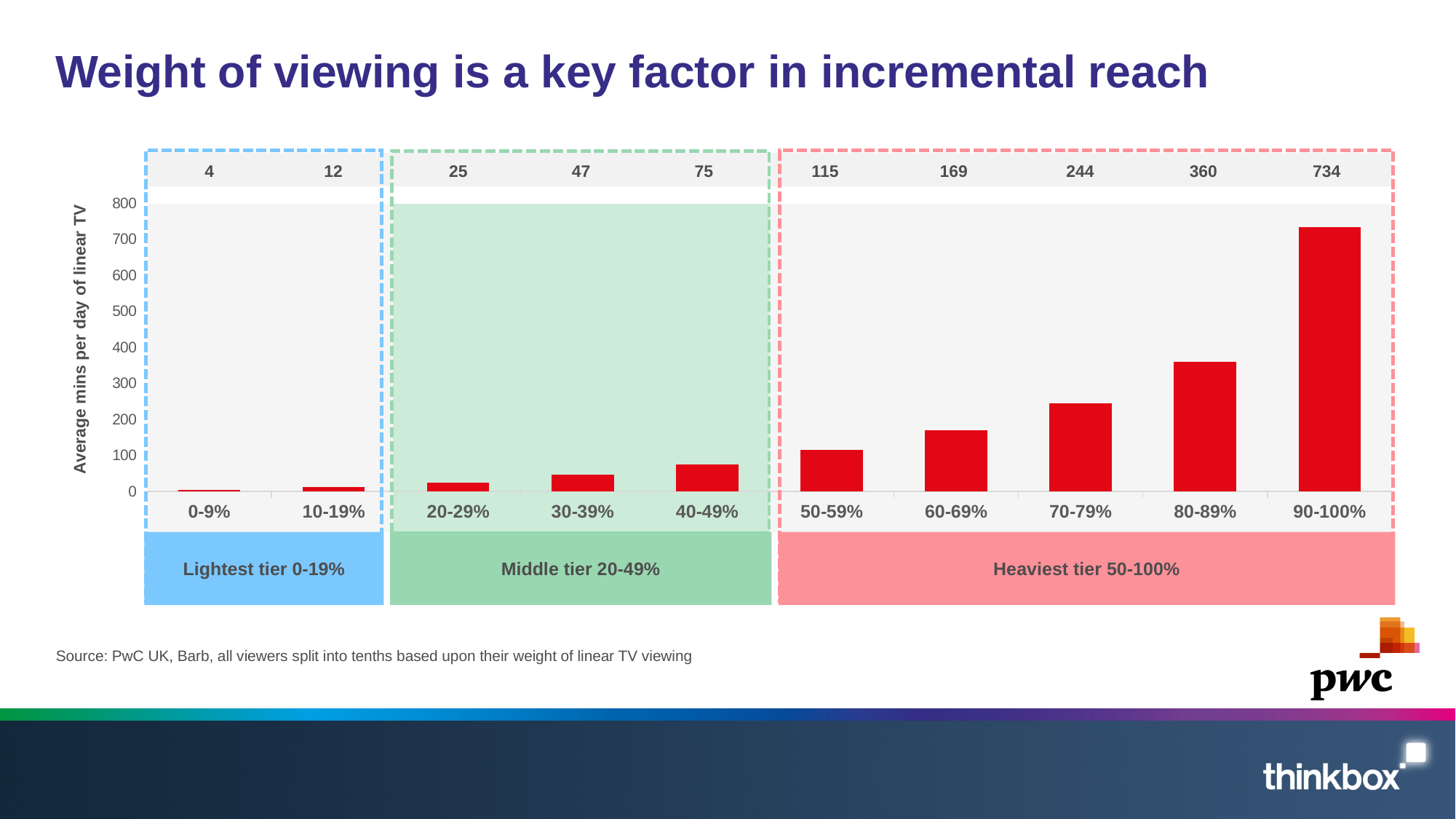
Which group has the lowest average minutes per day of linear TV? 0-9% What is the difference between the values for the 90-100% and 80-89% groups? 374 What is the value shown for the 0-9% group? 4 How many viewer groups are shown on the x axis? 10 What is the average minutes per day of linear TV for the 90-100% group? 734 What kind of chart is shown on the slide? Bar chart Do the values rise or fall moving from left to right along the x axis? Rise What is the value shown for the 30-39% group? 47 Which is larger, the value for 60-69% or the value for 70-79%? 70-79% What is the difference between the values for the 40-49% and 20-29% groups? 50 Is the value for the 80-89% group greater or less than 300? greater Which group has the highest average minutes per day of linear TV? 90-100%